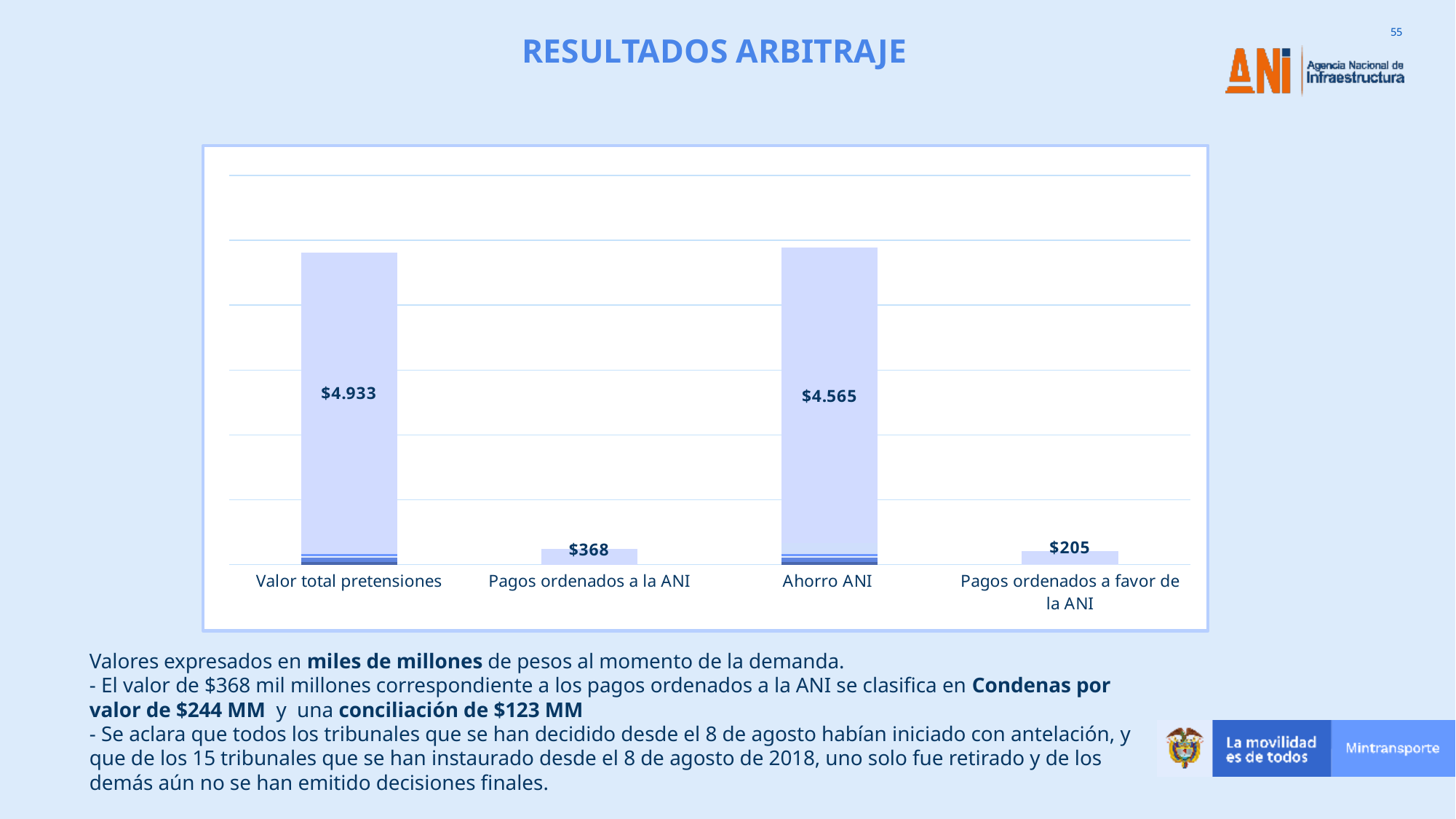
What is the difference between the values for Pagos ordenados a la ANI and Pagos ordenados a favor de la ANI? $163 Which is larger, the value for Ahorro ANI or the value for Pagos ordenados a la ANI? Ahorro ANI Which category has the lowest value in the chart? Pagos ordenados a favor de la ANI Which category has the highest value in the chart? Valor total pretensiones What is the value shown for Pagos ordenados a la ANI? $368 What kind of chart is shown on the slide? Bar chart What is the difference between the values for Valor total pretensiones and Ahorro ANI? $368 How many categories are shown in the chart? 4 What is the value shown for Ahorro ANI? $4.565 What is the value shown for Valor total pretensiones? $4.933 What is the value shown for Pagos ordenados a favor de la ANI? $205 What is the title of the slide containing the chart? RESULTADOS ARBITRAJE